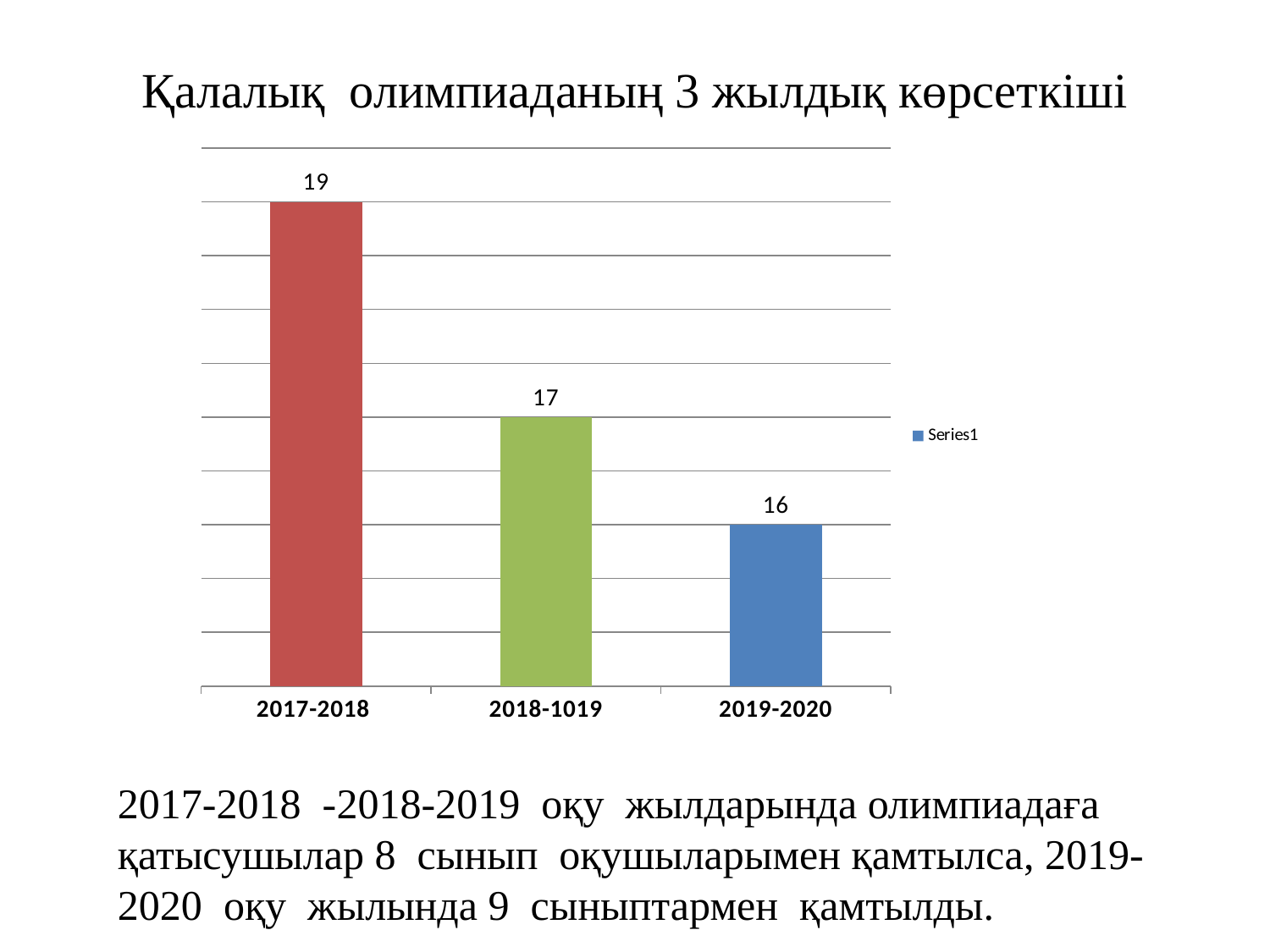
Which is larger, the value for 2018-1019 or the value for 2019-2020? 2018-1019 What is the difference between the values for 2017-2018 and 2019-2020? 3 What is the value for 2017-2018? 19 Which category has the lowest value? 2019-2020 How many series does the legend list? 1 How many categories are shown on the x axis? 3 Which category has the highest value? 2017-2018 What is the value for 2018-1019? 17 Do the values rise or fall from 2017-2018 to 2019-2020? fall What is the difference between the values for 2017-2018 and 2018-1019? 2 What kind of chart is shown on the slide? bar chart What is the value for 2019-2020? 16